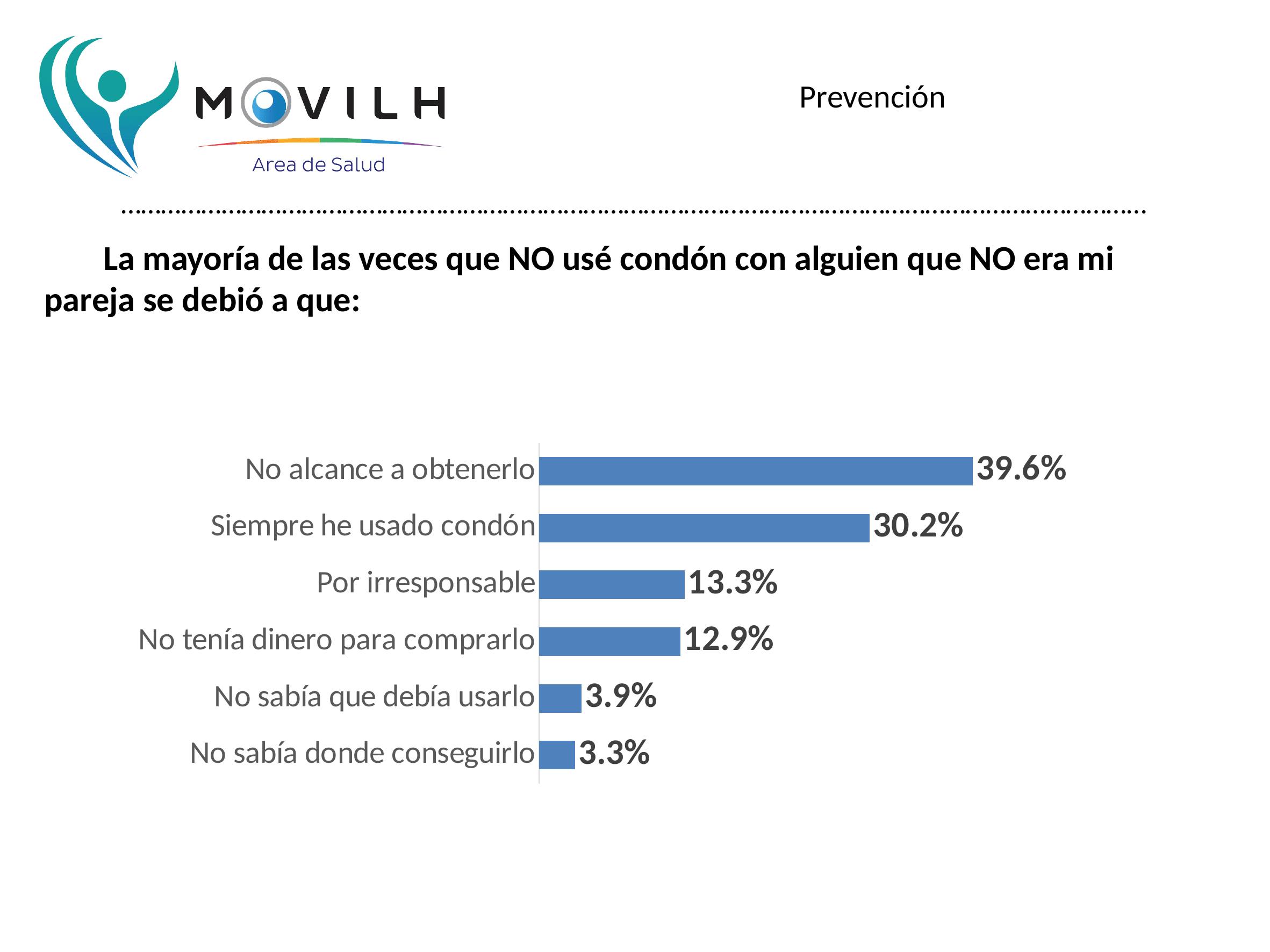
Which category has the lowest value? No sabía donde conseguirlo What kind of chart is shown on the slide? Bar chart Which is larger, the value for "Por irresponsable" or the value for "No tenía dinero para comprarlo"? Por irresponsable What is the value for "Siempre he usado condón"? 30.2% What is the value for "No tenía dinero para comprarlo"? 12.9% What is the value for "No sabía donde conseguirlo"? 3.3% What is the value for "No sabía que debía usarlo"? 3.9% What is the value for "Por irresponsable"? 13.3% How many categories are shown in the chart? 6 What is the value for "No alcance a obtenerlo"? 39.6% Which category has the highest value? No alcance a obtenerlo What is the difference between the values for "No alcance a obtenerlo" and "Siempre he usado condón"? 9.4%